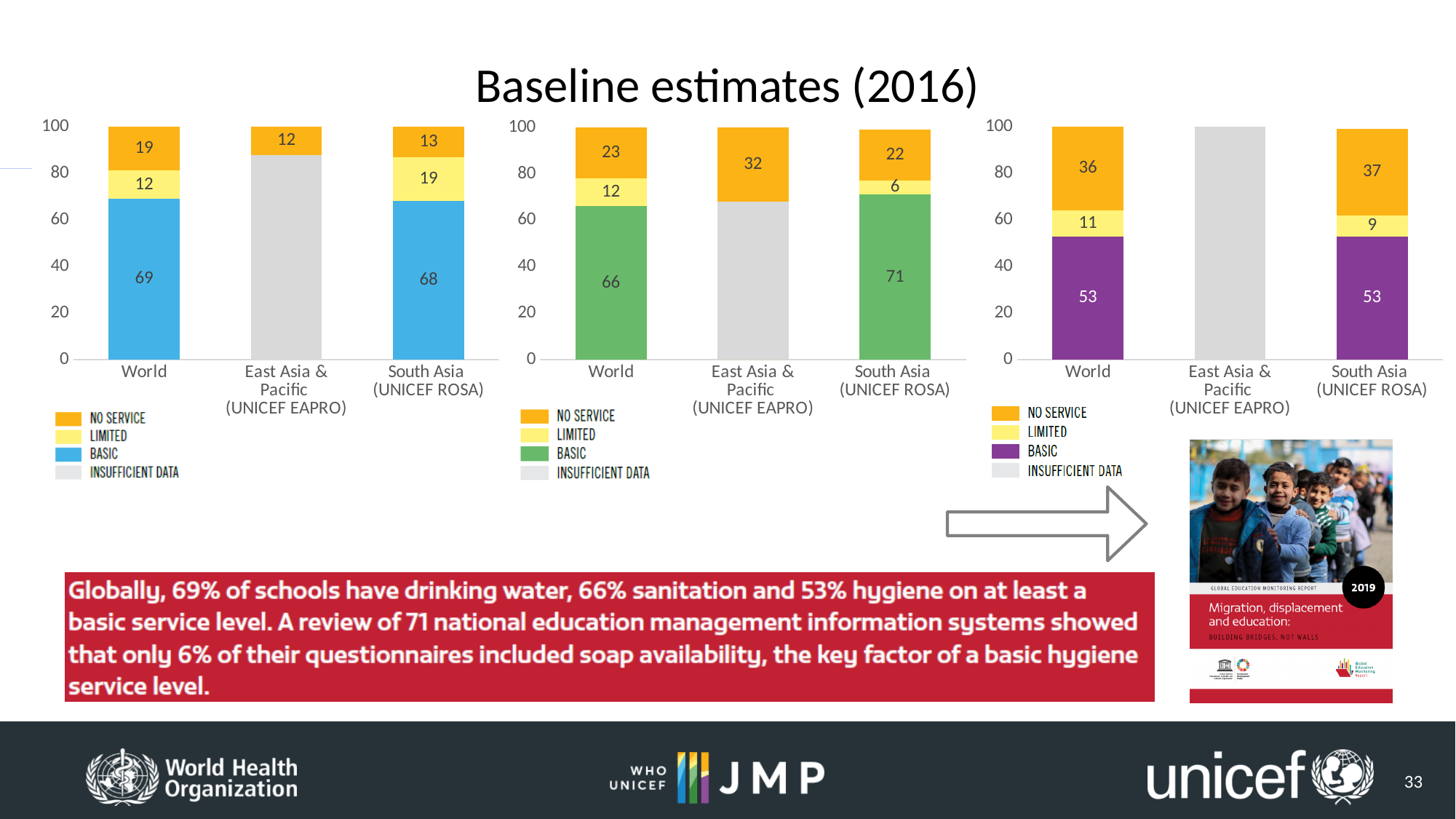
In the middle chart, what is the NO SERVICE value for East Asia & Pacific (UNICEF EAPRO)? 32 In the middle chart, what is the total of the BASIC, LIMITED and NO SERVICE segments for World? 101 In the right-hand chart, what is the LIMITED value for South Asia (UNICEF ROSA)? 9 In the middle chart, which category has the highest BASIC value? South Asia (UNICEF ROSA) In the left-hand chart, what is the BASIC value for World? 69 How many series does the legend of the middle chart list? 4 What kind of chart is the right-hand chart? Stacked bar chart In the left-hand chart, what is the difference between the LIMITED values for South Asia (UNICEF ROSA) and World? 7 In the right-hand chart, which category is shown entirely as INSUFFICIENT DATA? East Asia & Pacific (UNICEF EAPRO) In the right-hand chart, is the NO SERVICE value larger for World or for South Asia (UNICEF ROSA)? South Asia (UNICEF ROSA) What colour represents BASIC in the middle chart? Green How many categories are shown on the x axis of the left-hand chart? 3